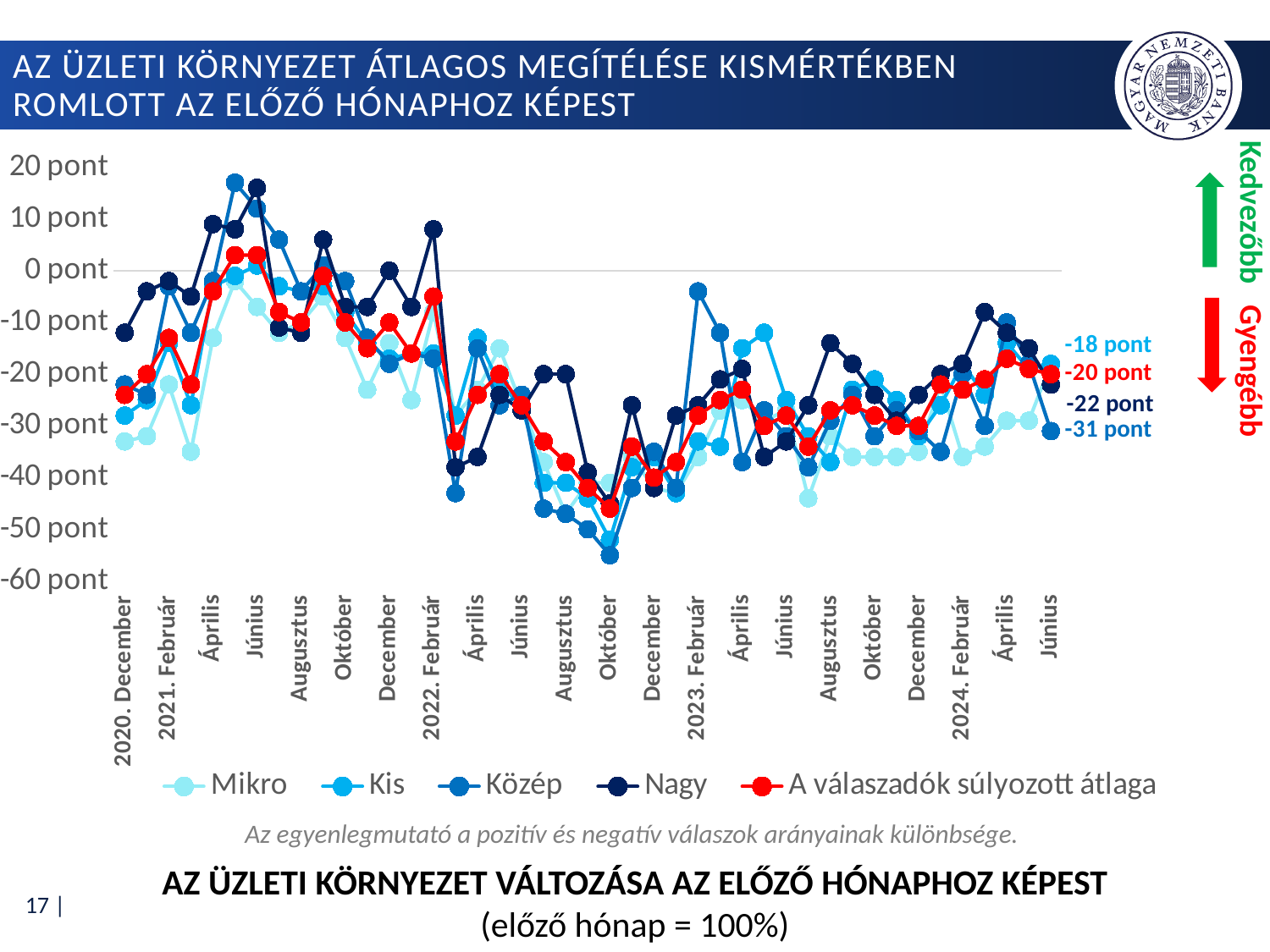
Is the value for the Mikro series in 2023 Augusztus greater or less than -40 pont? greater What kind of chart is shown on the slide? line chart What is the final labelled value for the Nagy series (2024 Június)? -22 pont What is the final labelled value for the Kis series (2024 Június)? -18 pont What is the difference between the final labelled values of Kis (-18 pont) and Közép (-31 pont)? 13 pont Is the value for the Nagy series in 2021 Június greater or less than 10 pont? greater Among the labelled end values, which series has the highest value in 2024 Június? Kis How many series does the legend list? 5 What is the final labelled value for 'A válaszadók súlyozott átlaga' (2024 Június)? -20 pont Which series is drawn in red? A válaszadók súlyozott átlaga What is the final labelled value for the Közép series (2024 Június)? -31 pont Among the labelled end values, which series has the lowest value in 2024 Június? Közép